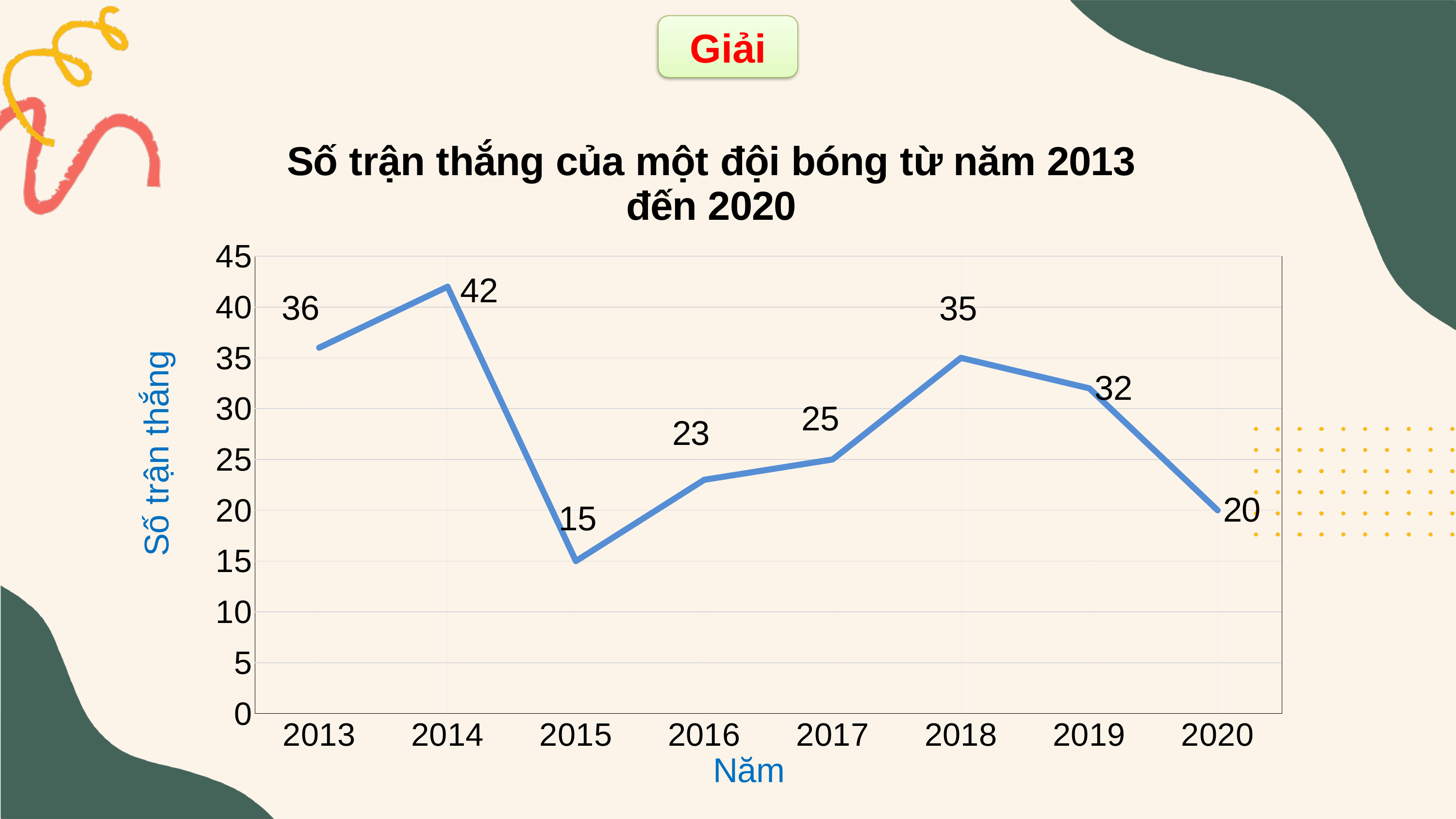
How many years are plotted on the chart? 8 What type of chart is shown on the slide? line chart Do the values rise or fall from 2015 to 2018? rise Which year has the lowest number of wins? 2015 What is the difference between the number of wins in 2018 and in 2019? 3 What is the number of wins in 2020? 20 What is the number of wins in 2014? 42 What is the difference between the number of wins in 2014 and in 2015? 27 Which year has the highest number of wins? 2014 What is the number of wins in 2017? 25 What is the title of the chart? Số trận thắng của một đội bóng từ năm 2013 đến 2020 Which year has more wins, 2013 or 2018? 2013